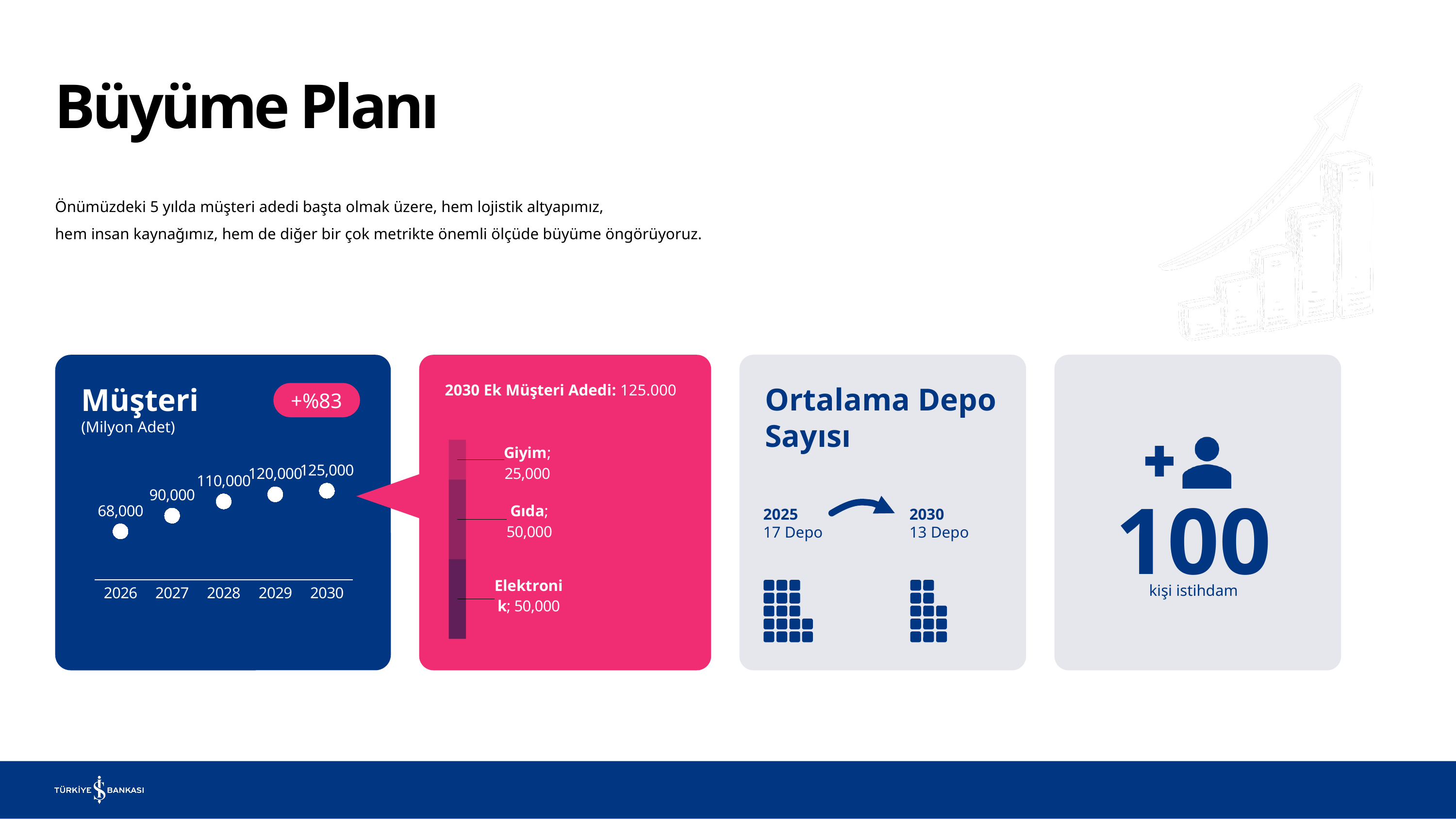
In the Müşteri chart, what is the value for 2026? 68,000 In the Müşteri chart, what is the difference between the values for 2027 and 2026? 22,000 In the Müşteri chart, how many years are plotted? 5 In the stacked bar chart in the pink box, what is the total of the stacked bar? 125,000 In the stacked bar chart in the pink box, what is the value for Giyim? 25,000 In the Müşteri chart, what is the value for 2028? 110,000 In the Müşteri chart, which year has the highest value? 2030 In the Müşteri chart, what is the value for 2030? 125,000 In the stacked bar chart in the pink box, what is the value for Gıda? 50,000 In the Müşteri chart, do the values rise or fall from 2026 to 2030? rise In the stacked bar chart in the pink box, which segment is smaller, Giyim or Elektronik? Giyim In the Müşteri chart, which year has the lowest value? 2026